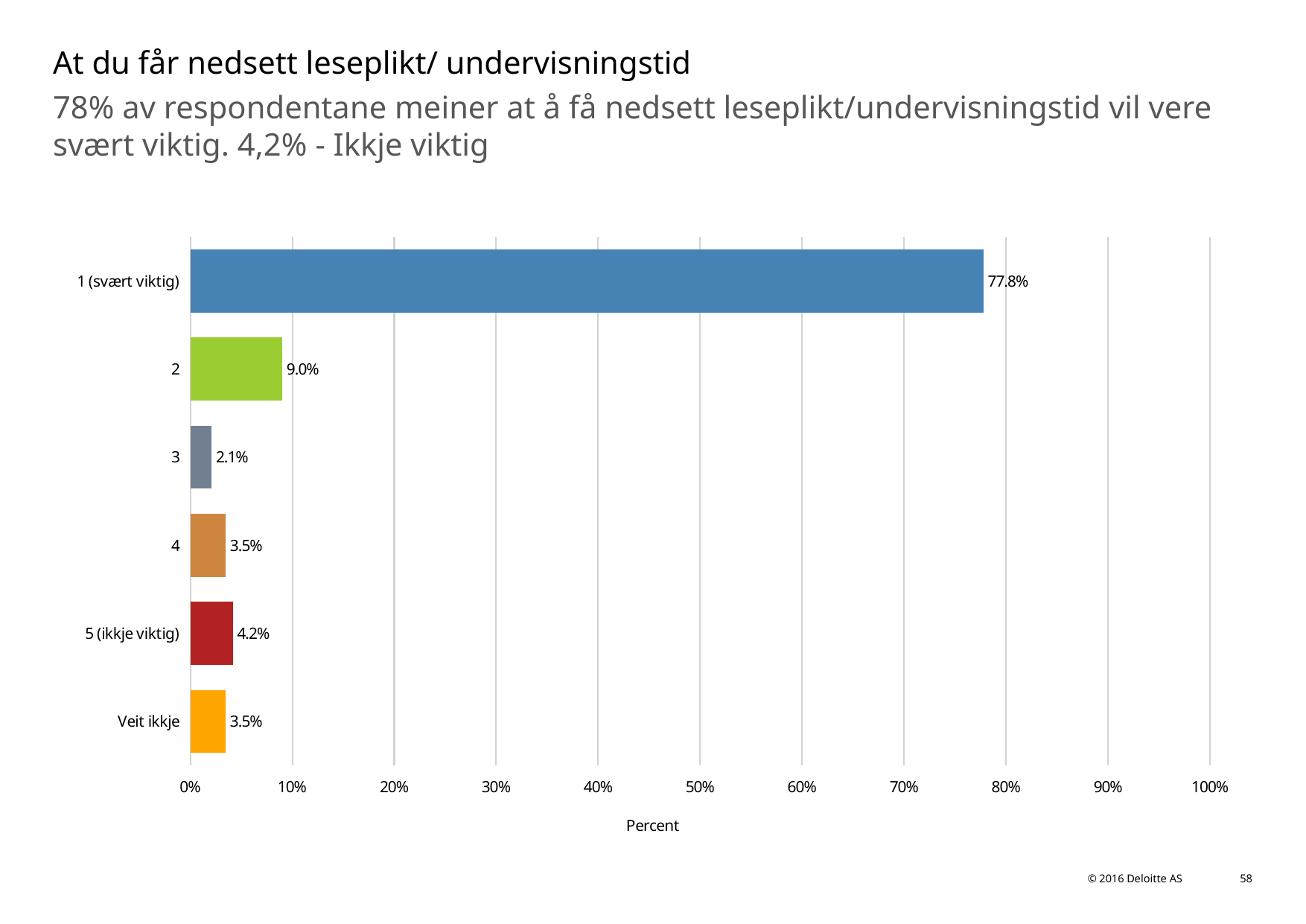
What is the value for "1 (svært viktig)"? 77.8% What is the value for "Veit ikkje"? 3.5% What is the difference between the values for "1 (svært viktig)" and "2"? 68.8 percentage points Which category has the highest value? 1 (svært viktig) Which category has the lowest value? 3 What kind of chart is shown on the slide? Bar chart What is the value for "5 (ikkje viktig)"? 4.2% Is the value for "1 (svært viktig)" greater or less than 70%? greater What is the value for category "2"? 9.0% How many categories are shown on the chart? 6 What is the label on the horizontal axis of the chart? Percent Which is larger, the value for "5 (ikkje viktig)" or the value for "4"? 5 (ikkje viktig)